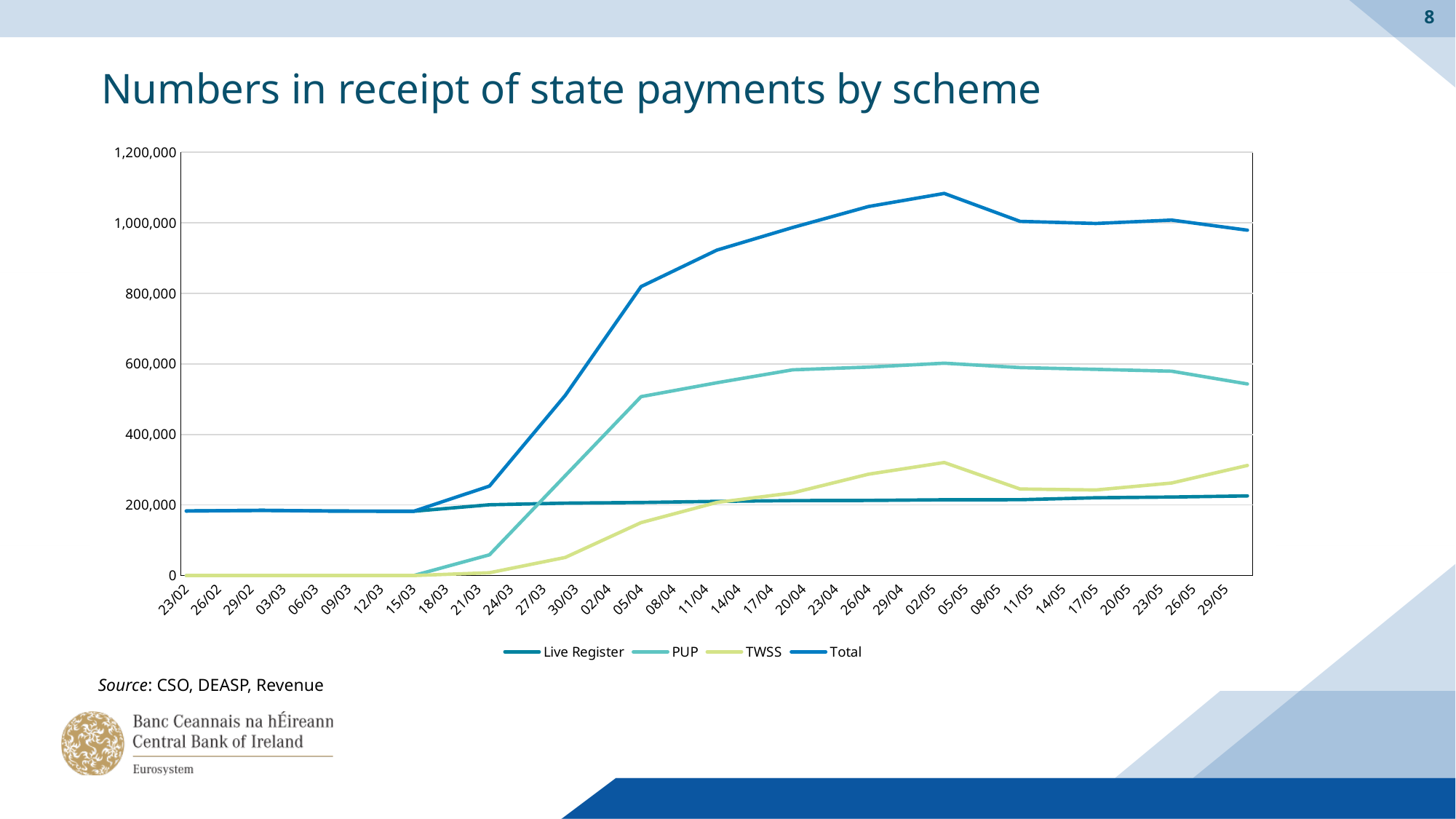
Which series are listed in the legend? Live Register, PUP, TWSS, Total Is the value for TWSS on 02/05 greater or less than 200,000? greater How many series does the legend list? 4 Which series has the highest value on 29/05? Total What is the title of the chart? Numbers in receipt of state payments by scheme Is the value for Live Register on 23/02 greater or less than 200,000? less Does the Total series rise or fall between 23/02 and 05/04? rise Is the value for PUP on 29/05 greater or less than 600,000? less On 29/05, which is larger, PUP or TWSS? PUP On 05/04, which is larger, Total or PUP? Total What kind of chart is shown on the slide? line chart